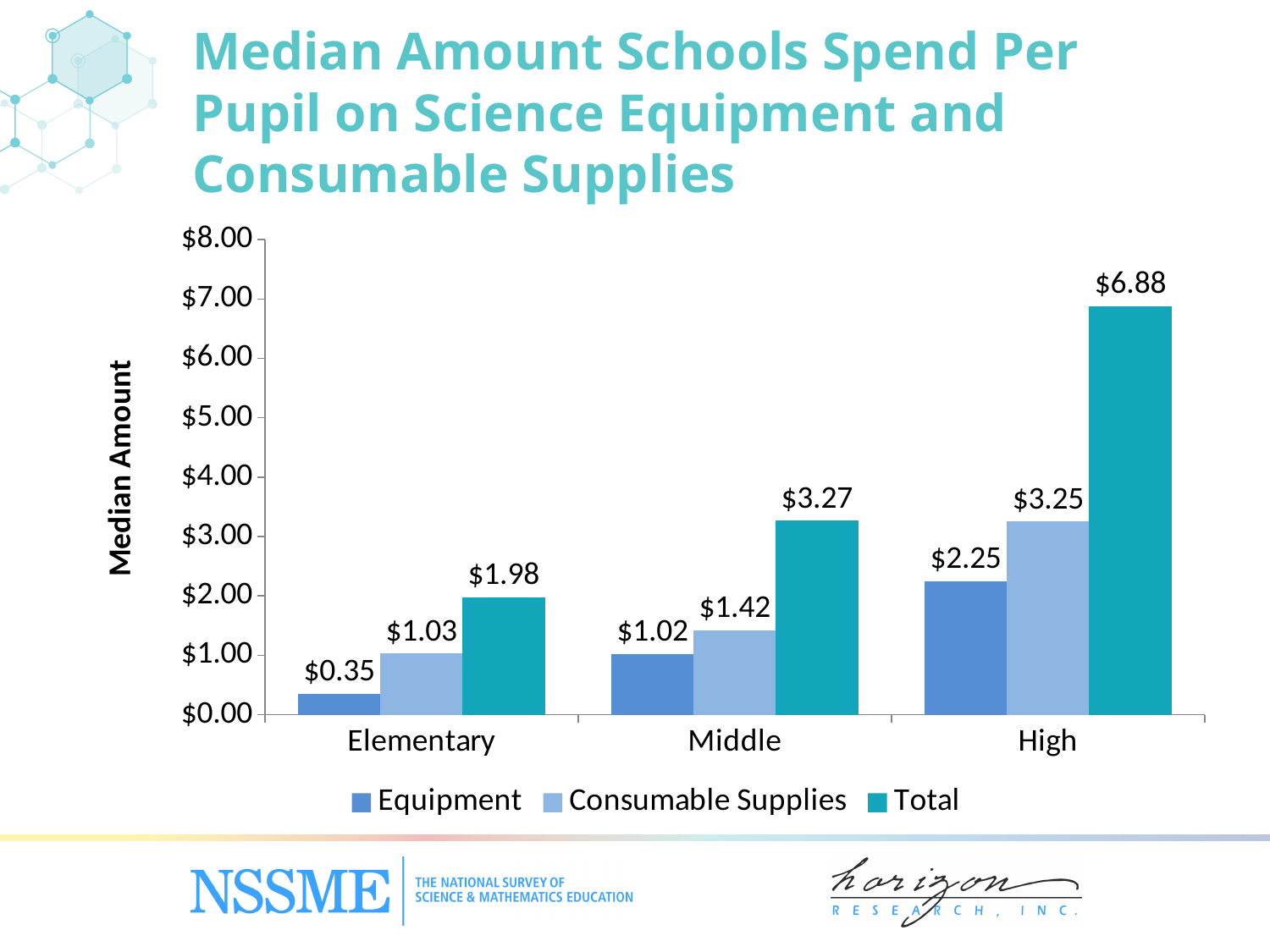
How many series does the legend list? 3 What is the Total median amount spent per pupil at High schools? $6.88 What is the median amount spent per pupil on Consumable Supplies at Middle schools? $1.42 Which school level has the highest Total median amount spent per pupil? High Does the Total median amount rise or fall from Elementary to High? Rise Is the Total median amount for Middle schools greater or less than $3.00? greater Which is larger at High schools: the median amount spent on Equipment or on Consumable Supplies? Consumable Supplies What is the difference between the Total median amount for High schools and for Middle schools? $3.61 What kind of chart is shown on the slide? Bar chart What is the median amount spent per pupil on Equipment at Elementary schools? $0.35 How many school levels are shown on the x axis? 3 Which school level has the lowest median amount spent per pupil on Equipment? Elementary